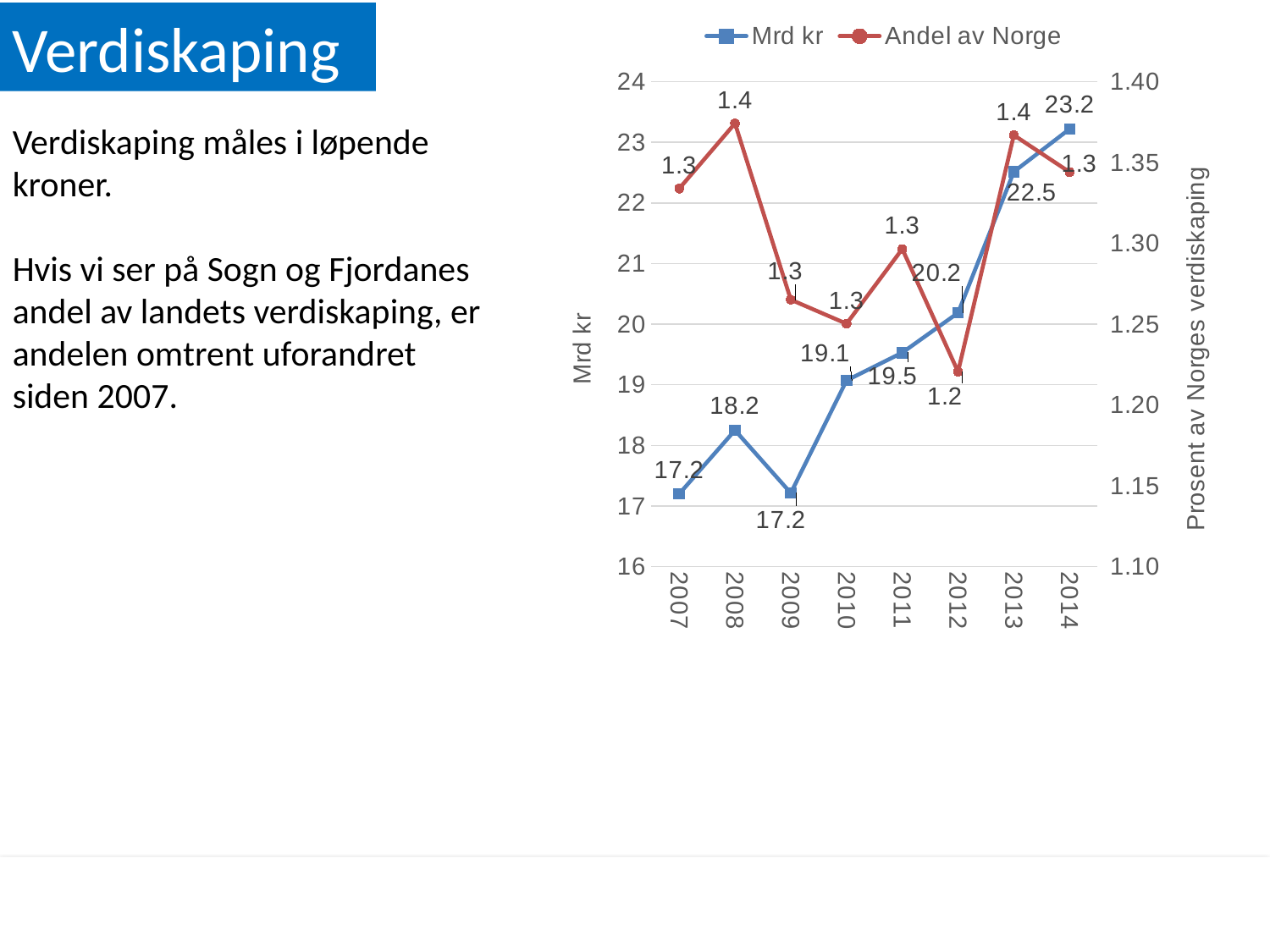
Does the Mrd kr series generally rise or fall from 2007 to 2014? Rise What is the Andel av Norge value for 2008? 1.4 In which year is the Mrd kr value highest? 2014 In which year is the Andel av Norge value lowest? 2012 What is the Mrd kr value for 2014? 23.2 What kind of chart is shown on the slide? Line chart How many years are shown on the x axis? 8 What is the Andel av Norge value for 2012? 1.2 Which year has the larger Mrd kr value, 2012 or 2013? 2013 What is the Mrd kr value for 2010? 19.1 How many series does the legend list? 2 What is the difference between the Mrd kr values for 2014 and 2007? 6.0